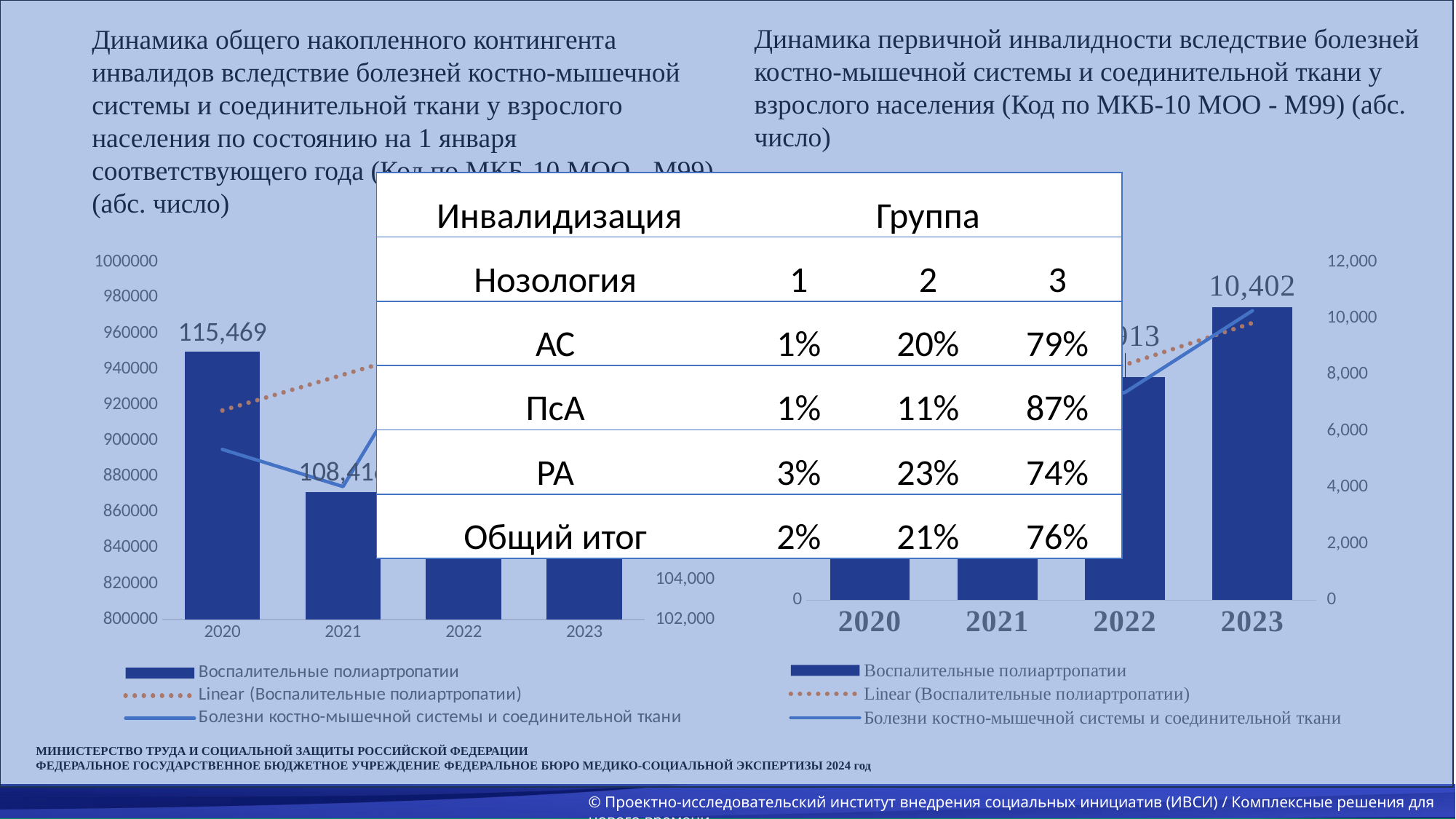
In the right chart, is the value of the 2023 bar greater or less than 8,000 on the right axis? greater In the right chart (Динамика первичной инвалидности...), what is the data label on the bar for 2023? 10,402 How many years are shown on the x axis of the left chart? 4 How many years are shown on the x axis of the right chart? 4 In the left chart, which legend entry is shown with a dotted line? Linear (Воспалительные полиартропатии) What kind of chart is the left chart? bar chart with lines How many entries does the legend of the right chart list? 3 In the left chart (Динамика общего накопленного контингента инвалидов...), what is the data label on the bar for 2020? 115,469 In the left chart, which bar is taller, 2020 or 2021? 2020 In the right chart, does the line for Болезни костно-мышечной системы и соединительной ткани rise or fall from 2022 to 2023? rise In the right chart, which legend entry is represented by the bars? Воспалительные полиартропатии